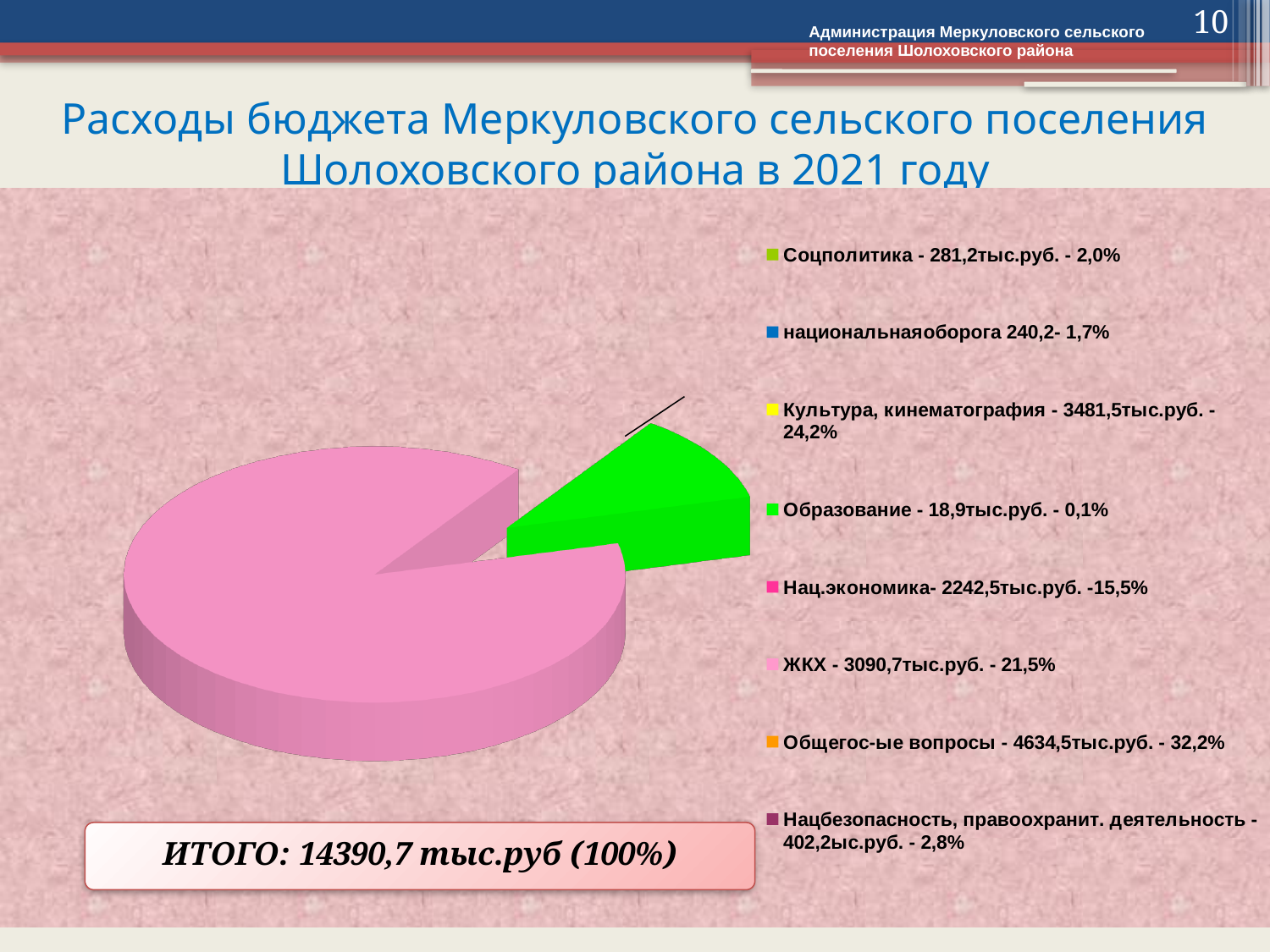
What is the difference between the values for Общегос-ые вопросы and Культура, кинематография? 1153,0 тыс.руб. According to the legend, what share of the budget expenses is Нац.экономика? 15,5% Which is larger according to the legend: ЖКХ or Нац.экономика? ЖКХ According to the legend, what share of the budget expenses is ЖКХ? 21,5% How many categories does the legend of the pie chart list? 8 What is the total (ИТОГО) of the budget expenses shown on the slide? 14390,7 тыс.руб According to the legend, what is the value for Соцполитика? 281,2тыс.руб. Which category has the smallest share according to the legend? Образование What kind of chart is shown on the slide? pie chart What colour is the Образование slice in the legend? green Which category has the largest share according to the legend? Общегос-ые вопросы According to the legend, what is the value for Культура, кинематография? 3481,5тыс.руб.